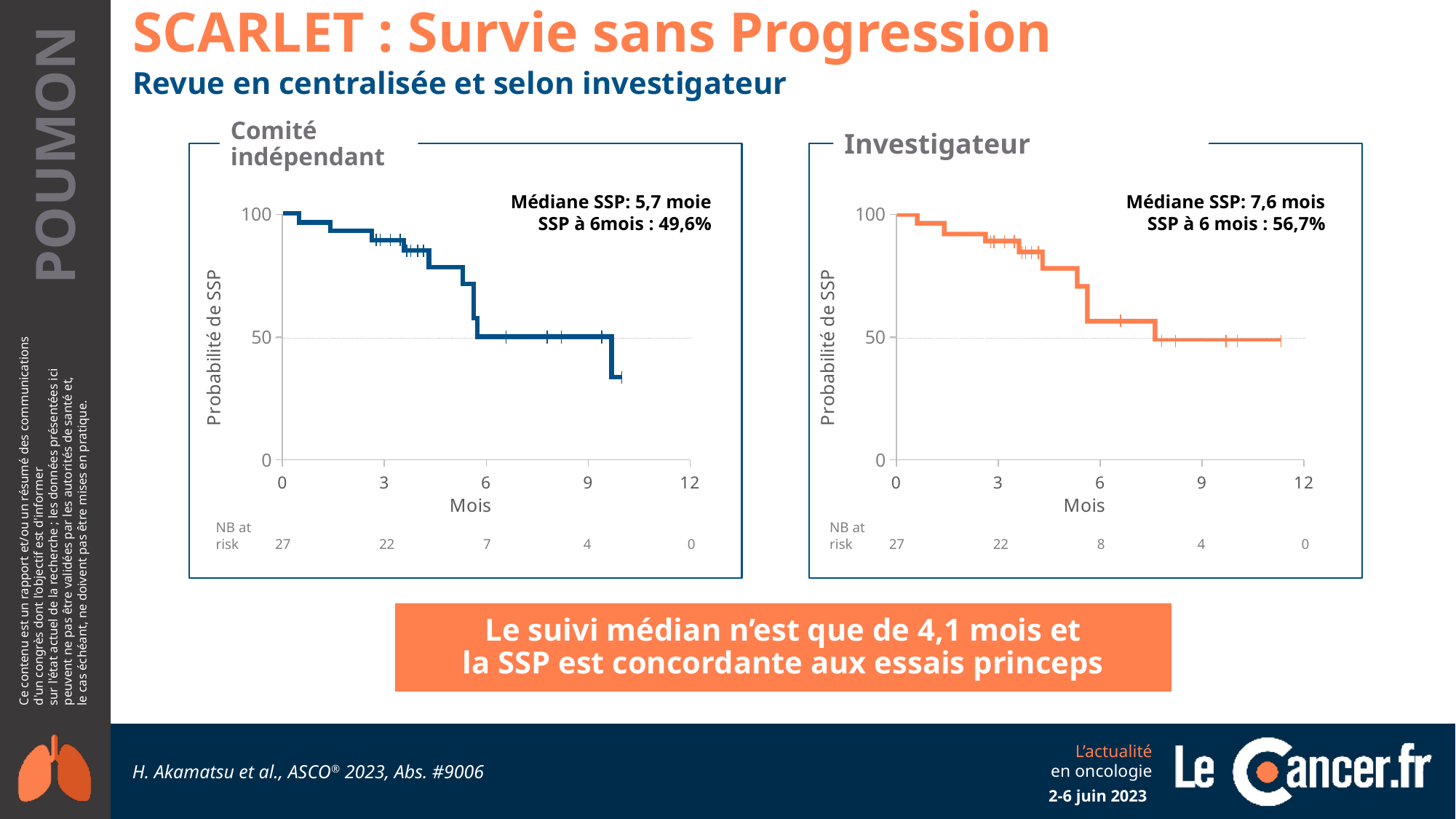
In the 'Comité indépendant' chart, how many patients are at risk at 6 months? 7 What kind of chart is shown in the 'Comité indépendant' panel? Kaplan-Meier survival (step line) curve In the 'Comité indépendant' chart, what is the median SSP shown? 5,7 mois In the 'Investigateur' chart, what is the SSP at 6 months? 56,7% In the 'Investigateur' chart, how many patients are at risk at 0 months? 27 In the 'Investigateur' chart, what is the median SSP shown? 7,6 mois In the 'Investigateur' chart, how many patients are at risk at 6 months? 8 In the 'Comité indépendant' chart, is the probability of SSP at 3 months greater or less than 50? greater Which chart reports the higher SSP at 6 months, 'Comité indépendant' or 'Investigateur'? Investigateur In the 'Comité indépendant' chart, what is the SSP at 6 months? 49,6% In the 'Investigateur' chart, does the probability of SSP rise or fall as months increase? Fall What is the difference in SSP at 6 months between the 'Investigateur' chart and the 'Comité indépendant' chart? 7,1 points